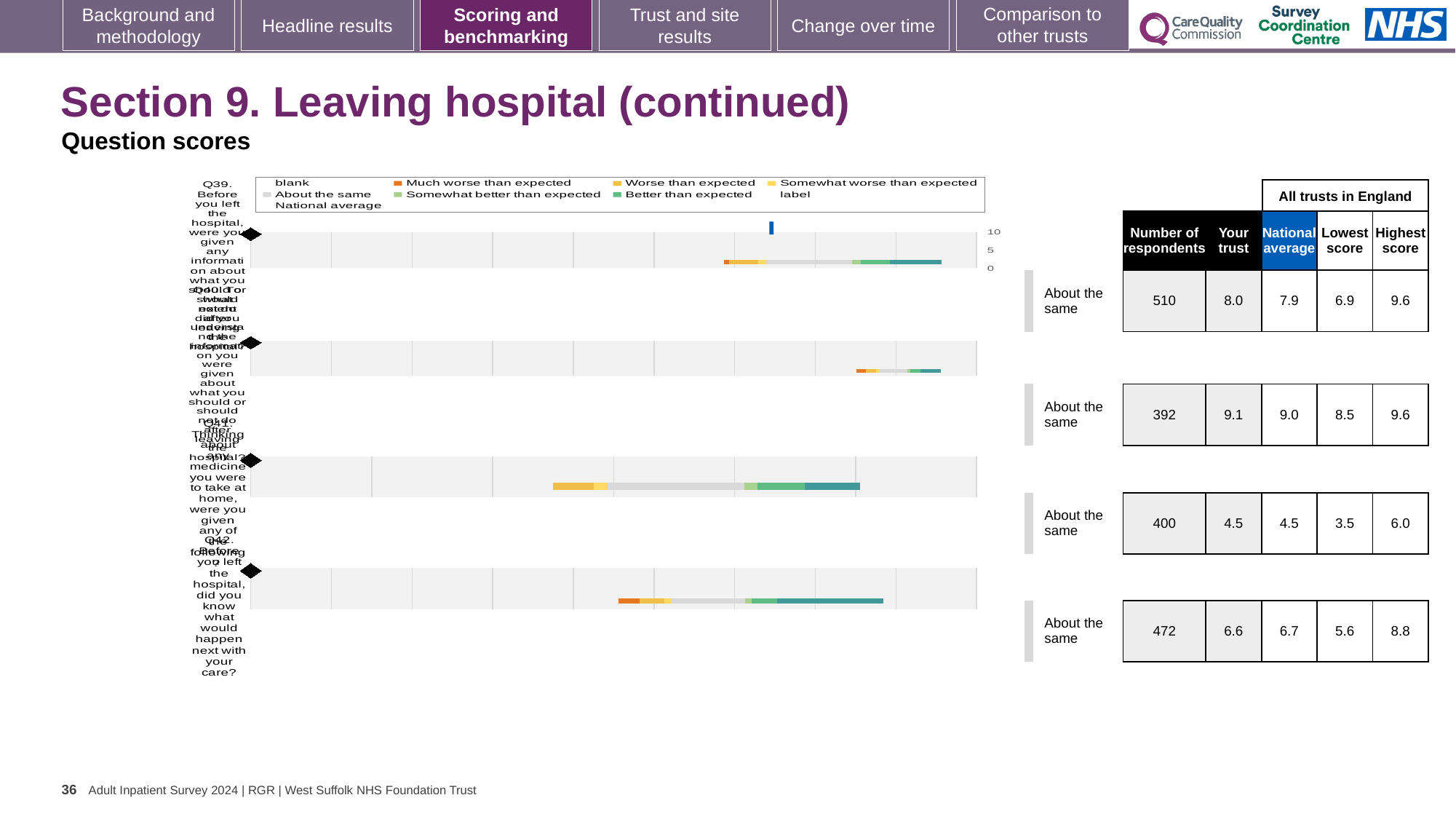
What is the 'Your trust' score for Q39 (Before you left the hospital, were you given any information about what you should or should not do after leaving hospital?)? 8.0 What is the national average score for Q39? 7.9 How many respondents answered Q42? 472 What benchmark category is shown next to each of the four question charts? About the same What is the highest score across all trusts in England for Q42? 8.8 What type of chart is used for the question scores on this slide? bar chart How many respondents answered Q39? 510 What is the difference between the 'Your trust' score and the national average for Q42? 0.1 Which legend entry is shown in dark orange? Much worse than expected How many question charts are shown on the slide? 4 Which has the larger 'Your trust' score, Q39 or Q42? Q39 What is the 'Your trust' score for Q42 (Before you left the hospital, did you know what would happen next with your care?)? 6.6